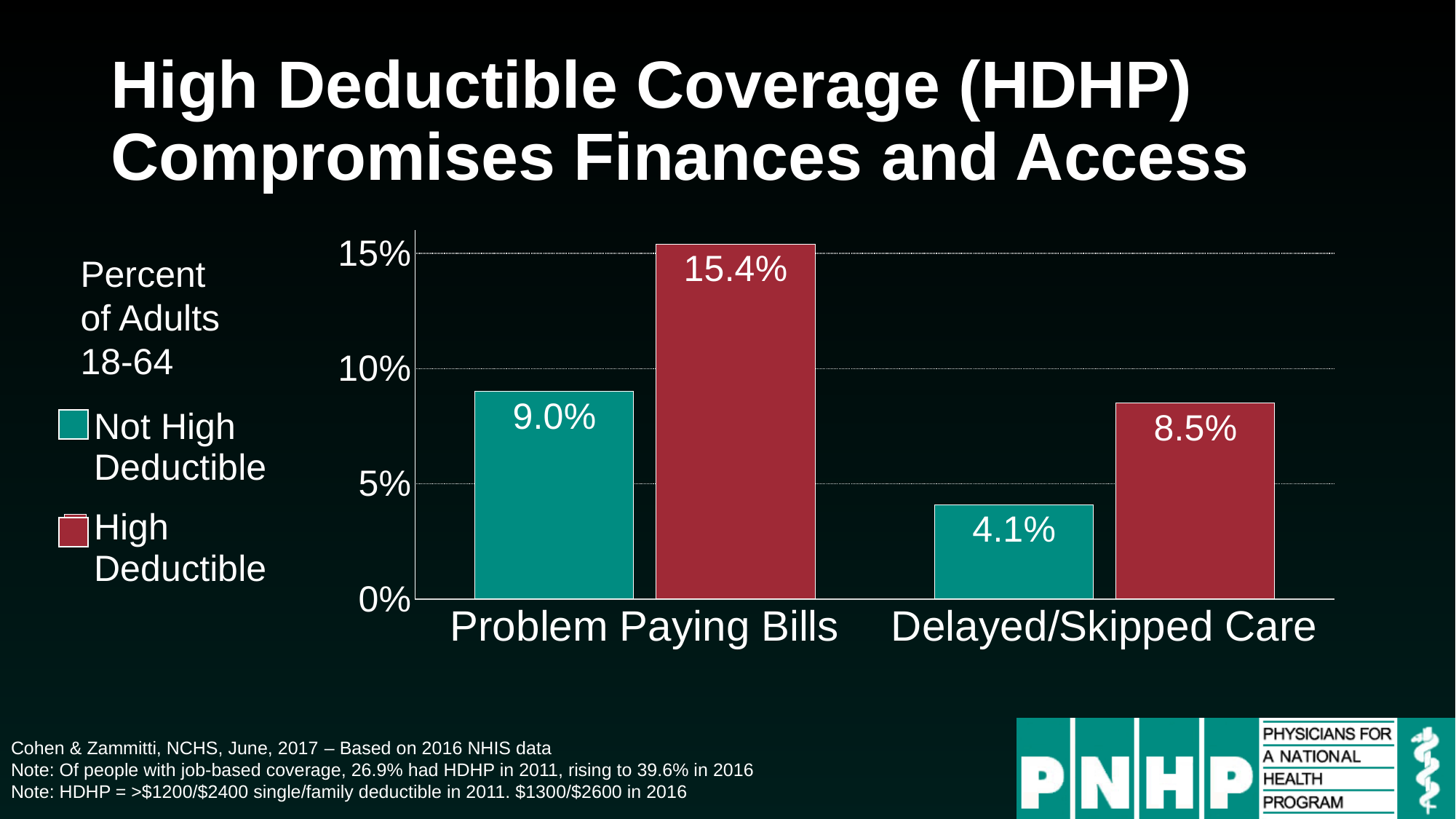
What percentage of adults with Not High Deductible coverage had a Problem Paying Bills? 9.0% What is the difference between the High Deductible and Not High Deductible values for Delayed/Skipped Care? 4.4% Which bar in the chart has the lowest value? Not High Deductible, Delayed/Skipped Care How many series does the legend list? 2 What percentage of adults with High Deductible coverage reported Delayed/Skipped Care? 8.5% What percentage of adults with High Deductible coverage had a Problem Paying Bills? 15.4% For Delayed/Skipped Care, which group has the larger value: High Deductible or Not High Deductible? High Deductible What is the difference between the High Deductible and Not High Deductible values for Problem Paying Bills? 6.4% Which bar in the chart has the highest value? High Deductible, Problem Paying Bills What type of chart is shown on the slide? Bar chart How many categories are shown on the x axis? 2 What percentage of adults with Not High Deductible coverage reported Delayed/Skipped Care? 4.1%